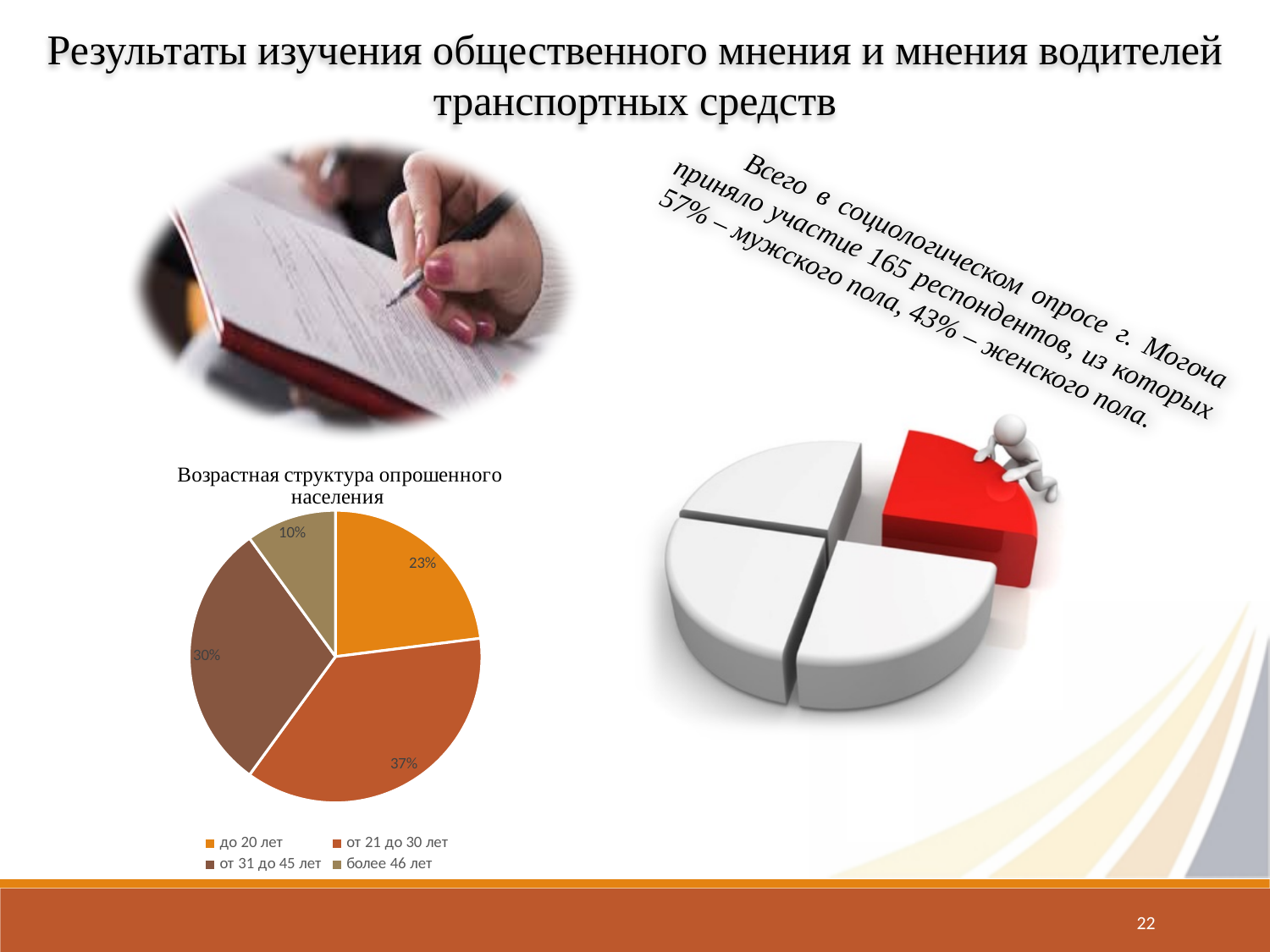
Which slice is larger: 'от 31 до 45 лет' or 'до 20 лет'? от 31 до 45 лет What colour is the slice for 'до 20 лет' in the pie chart? orange Which age group has the smallest share in the pie chart? более 46 лет What share of respondents are aged 'от 31 до 45 лет' in the pie chart? 30% What share of respondents are aged 'до 20 лет' in the pie chart? 23% What share of respondents are aged 'от 21 до 30 лет' in the pie chart 'Возрастная структура опрошенного населения'? 37% What type of chart is used to show the age structure of the surveyed population? pie chart What share of respondents are aged 'более 46 лет' in the pie chart? 10% What is the difference in percentage points between the 'от 21 до 30 лет' and 'до 20 лет' slices? 14 How many age groups are shown in the pie chart? 4 What is the title of the chart on the slide? Возрастная структура опрошенного населения Which age group has the largest share in the pie chart? от 21 до 30 лет